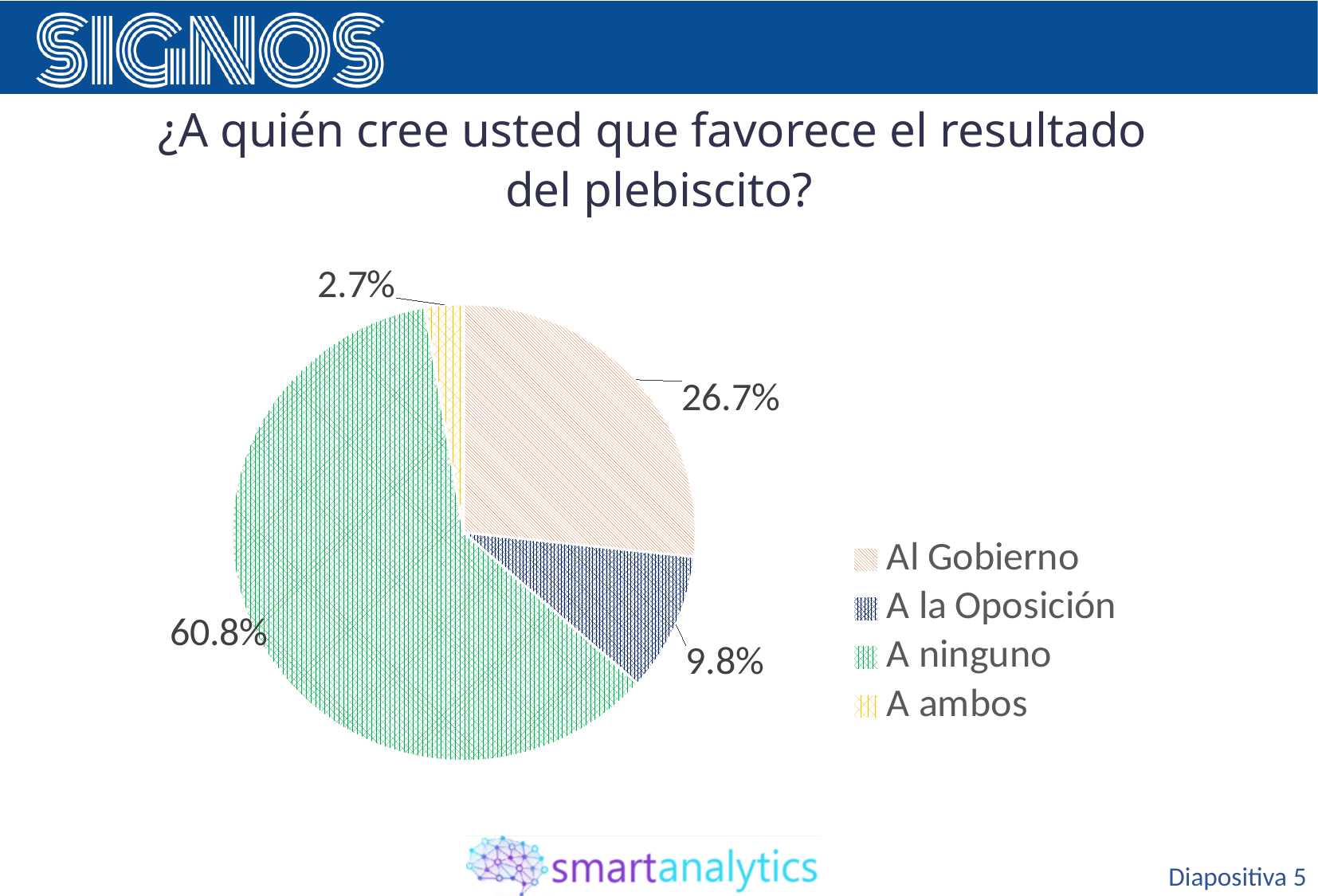
What percentage of respondents answered "Al Gobierno"? 26.7% Which category has the largest share of the pie? A ninguno What percentage of respondents answered "A la Oposición"? 9.8% What is the difference in percentage points between "A ninguno" and "Al Gobierno"? 34.1 What percentage of respondents answered "A ninguno"? 60.8% What percentage of respondents answered "A ambos"? 2.7% What is the title of the chart on the slide? ¿A quién cree usted que favorece el resultado del plebiscito? How many categories does the pie chart show? 4 Which is larger, the share for "Al Gobierno" or the share for "A la Oposición"? Al Gobierno Which category has the smallest share of the pie? A ambos What is the difference in percentage points between "Al Gobierno" and "A la Oposición"? 16.9 What kind of chart is shown on the slide? Pie chart